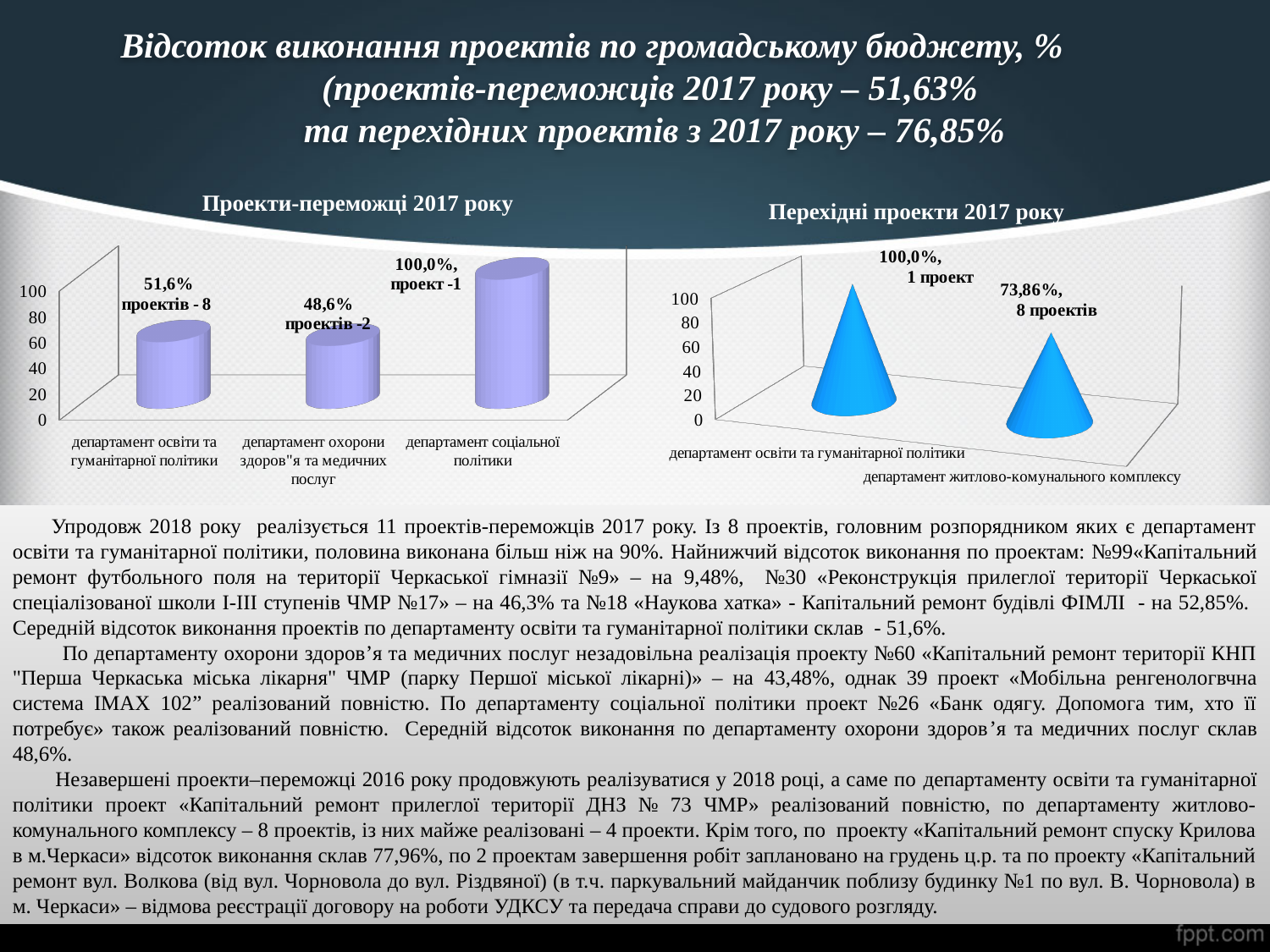
In the chart titled "Проекти-переможці 2017 року", how many categories are shown? 3 In the chart titled "Проекти-переможці 2017 року", how many projects are noted for департамент освіти та гуманітарної політики? 8 In the chart titled "Перехідні проекти 2017 року", what is the value for департамент житлово-комунального комплексу? 73,86% In the chart titled "Проекти-переможці 2017 року", what is the difference between the value for департамент соціальної політики and the value for департамент освіти та гуманітарної політики? 48,4% In the chart titled "Перехідні проекти 2017 року", what is the value for департамент освіти та гуманітарної політики? 100,0% What kind of chart is the chart titled "Проекти-переможці 2017 року"? bar chart In the chart titled "Проекти-переможці 2017 року", what is the value for департамент освіти та гуманітарної політики? 51,6% In the chart titled "Проекти-переможці 2017 року", what is the value for департамент охорони здоров"я та медичних послуг? 48,6% In the chart titled "Перехідні проекти 2017 року", which category has the higher value: департамент освіти та гуманітарної політики or департамент житлово-комунального комплексу? департамент освіти та гуманітарної політики In the chart titled "Перехідні проекти 2017 року", how many categories are shown? 2 In the chart titled "Проекти-переможці 2017 року", which category has the highest value? департамент соціальної політики In the chart titled "Проекти-переможці 2017 року", which category has the lowest value? департамент охорони здоров"я та медичних послуг